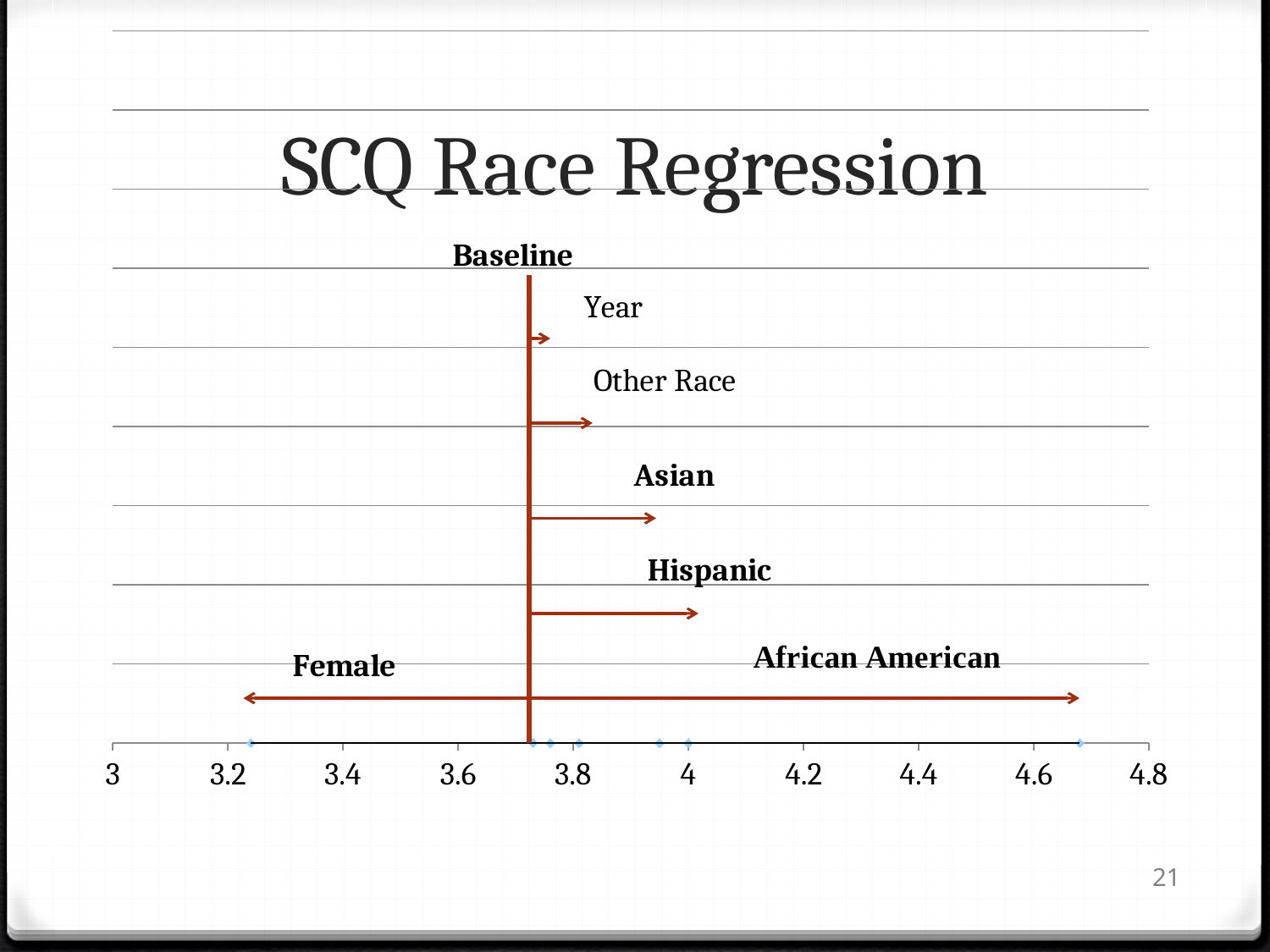
Is the value at the end of the Female arrow greater or less than 3.4? less Which category's arrow extends furthest to the left on the x axis? Female Is the Baseline value greater or less than 3.6? greater Which arrow reaches a higher value on the x axis, Hispanic or Asian? Hispanic Is the value at the end of the Year arrow greater or less than 3.8? less Which category's arrow extends furthest to the right on the x axis? African American How many labelled categories have arrows drawn from the Baseline? 6 What is the highest value shown on the x axis? 4.8 What is the title of the chart? SCQ Race Regression Which arrow reaches a higher value on the x axis, Other Race or Year? Other Race